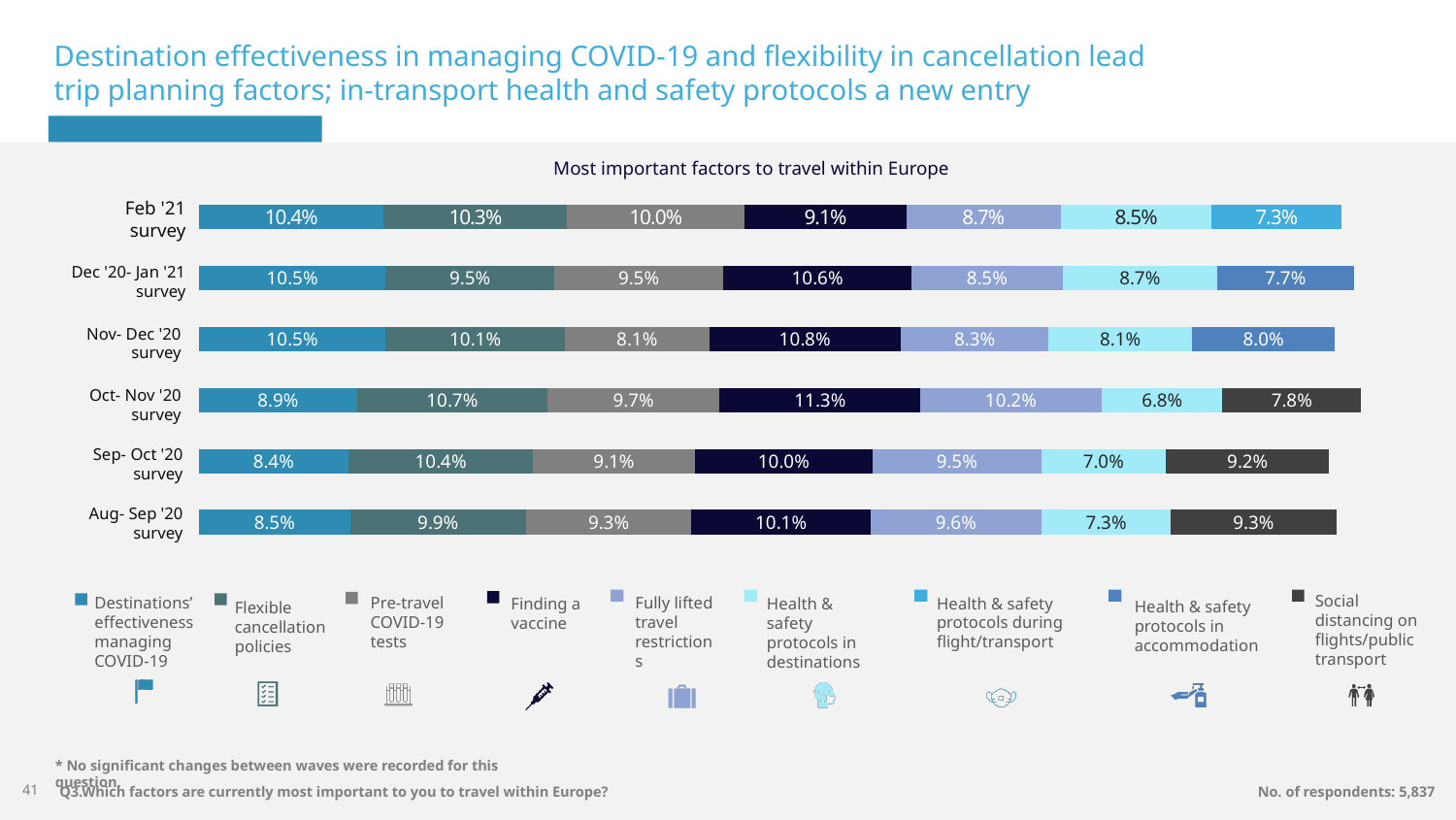
In which survey wave was the share for 'Destinations' effectiveness managing COVID-19' lowest? Sep-Oct '20 survey In the Oct-Nov '20 survey, which is larger: 'Finding a vaccine' or 'Destinations' effectiveness managing COVID-19'? Finding a vaccine From the Oct-Nov '20 survey to the Feb '21 survey, does the share for 'Finding a vaccine' rise or fall? Fall What share did 'Flexible cancellation policies' receive in the Oct-Nov '20 survey? 10.7% What kind of chart is shown on the slide? Stacked bar chart How many factors does the legend list? 9 What share did 'Finding a vaccine' receive in the Oct-Nov '20 survey? 11.3% How many survey waves are plotted in the chart? 6 What is the chart's title? Most important factors to travel within Europe What share did 'Destinations' effectiveness managing COVID-19' receive in the Feb '21 survey? 10.4% In which survey wave was the share for 'Finding a vaccine' highest? Oct-Nov '20 survey By how many percentage points does 'Destinations' effectiveness managing COVID-19' in the Feb '21 survey exceed its value in the Aug-Sep '20 survey? 1.9 percentage points